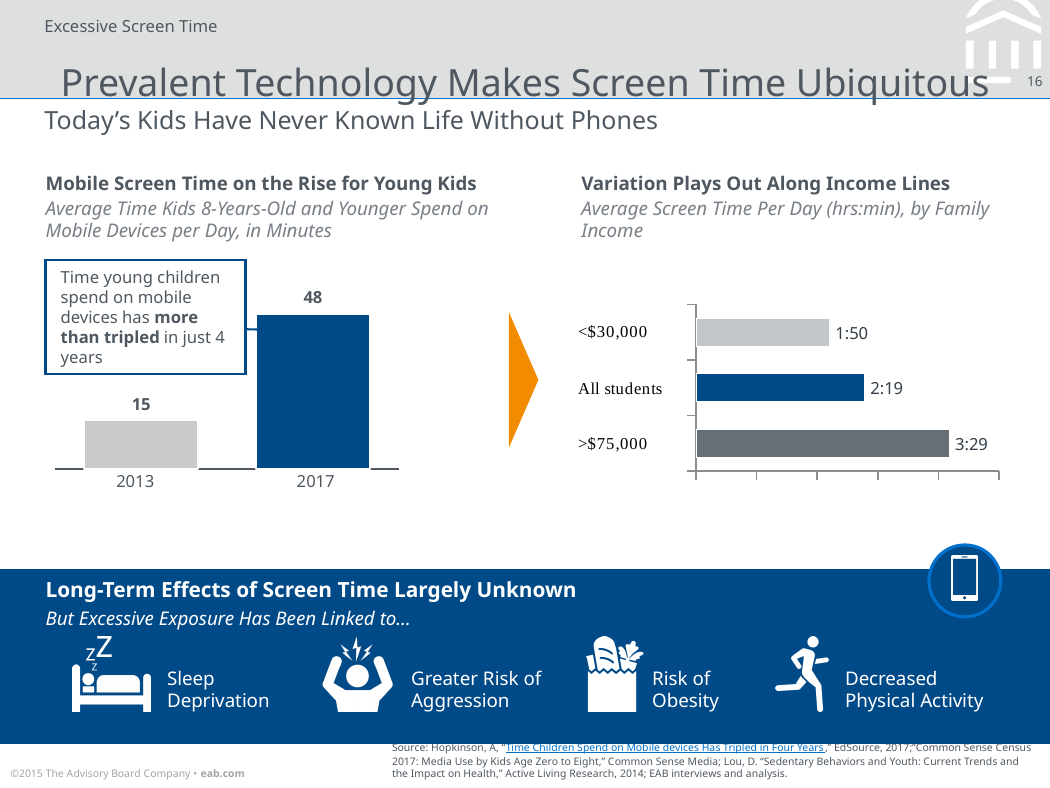
In the 'Mobile Screen Time on the Rise for Young Kids' chart, what is the value for 2017? 48 In the 'Mobile Screen Time on the Rise for Young Kids' chart, what is the value for 2013? 15 In the 'Variation Plays Out Along Income Lines' chart, what is the value for All students? 2:19 What kind of chart is 'Mobile Screen Time on the Rise for Young Kids'? Bar chart In the 'Variation Plays Out Along Income Lines' chart, what is the average screen time per day for families earning >$75,000? 3:29 In the 'Variation Plays Out Along Income Lines' chart, which category has the highest value? >$75,000 In the 'Mobile Screen Time on the Rise for Young Kids' chart, do the values rise or fall from 2013 to 2017? Rise In the 'Variation Plays Out Along Income Lines' chart, how many categories are shown? 3 In the 'Mobile Screen Time on the Rise for Young Kids' chart, by how much did the value increase from 2013 to 2017? 33 In the 'Variation Plays Out Along Income Lines' chart, which category has the lowest value? <$30,000 In the 'Mobile Screen Time on the Rise for Young Kids' chart, how many bars are plotted? 2 In the 'Variation Plays Out Along Income Lines' chart, which is larger: the value for <$30,000 or for All students? All students